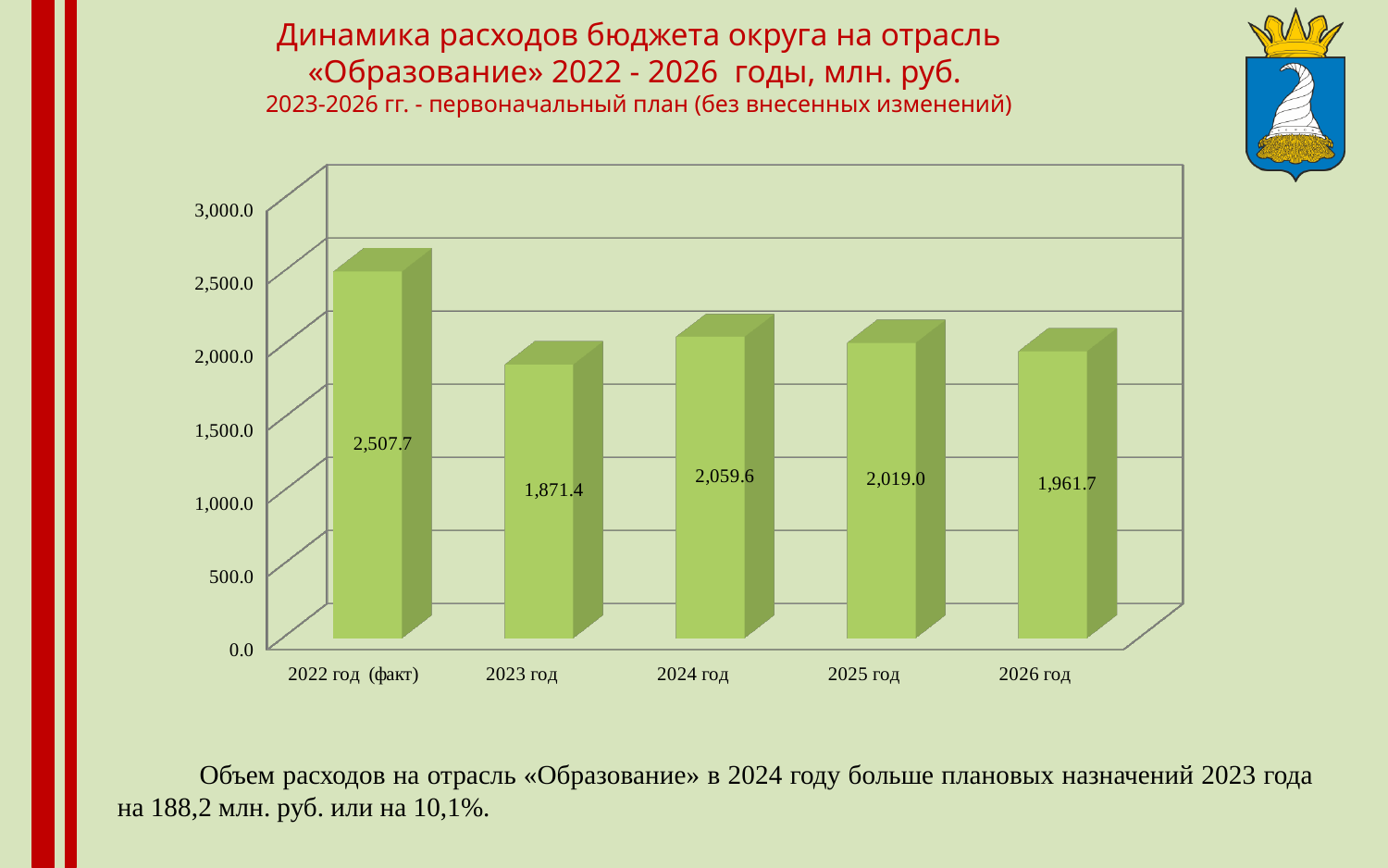
Is the value for 2023 год greater or less than 2,000.0? less How many years are shown on the chart? 5 Which year has the highest value? 2022 год (факт) What kind of chart is shown on the slide? bar chart Which is larger, the value for 2025 год or the value for 2026 год? 2025 год What is the value for 2024 год? 2,059.6 Which year has the lowest value? 2023 год What is the difference between the values for 2022 год (факт) and 2023 год? 636.3 What is the difference between the values for 2024 год and 2023 год? 188.2 What is the value for 2026 год? 1,961.7 From 2024 год to 2026 год, do the values rise or fall? fall What is the value for 2022 год (факт)? 2,507.7